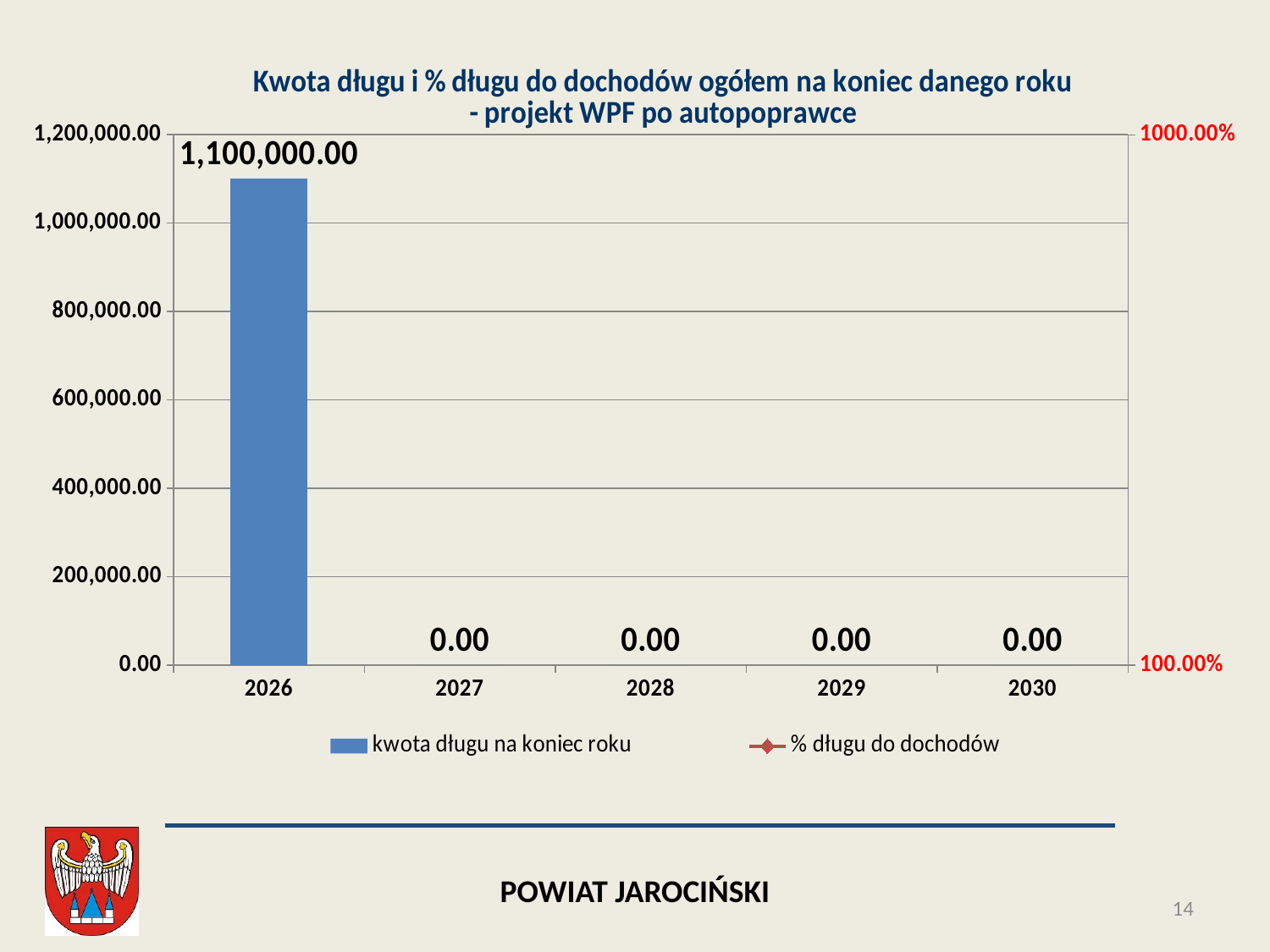
What is the value of "kwota długu na koniec roku" for 2026? 1,100,000.00 How many years are shown on the x axis? 5 What is the name of the second series listed in the legend? % długu do dochodów Which is larger, the "kwota długu na koniec roku" value for 2026 or for 2029? 2026 Is the value for 2026 greater or less than 1,000,000.00? greater What is the value of "kwota długu na koniec roku" for 2030? 0.00 What is the value of "kwota długu na koniec roku" for 2028? 0.00 Which year has the highest value of "kwota długu na koniec roku"? 2026 How many series does the legend list? 2 What kind of chart is used to show "kwota długu na koniec roku"? bar chart Do the "kwota długu na koniec roku" values rise or fall from 2026 to 2027? fall What is the difference between the "kwota długu na koniec roku" values for 2026 and 2027? 1,100,000.00